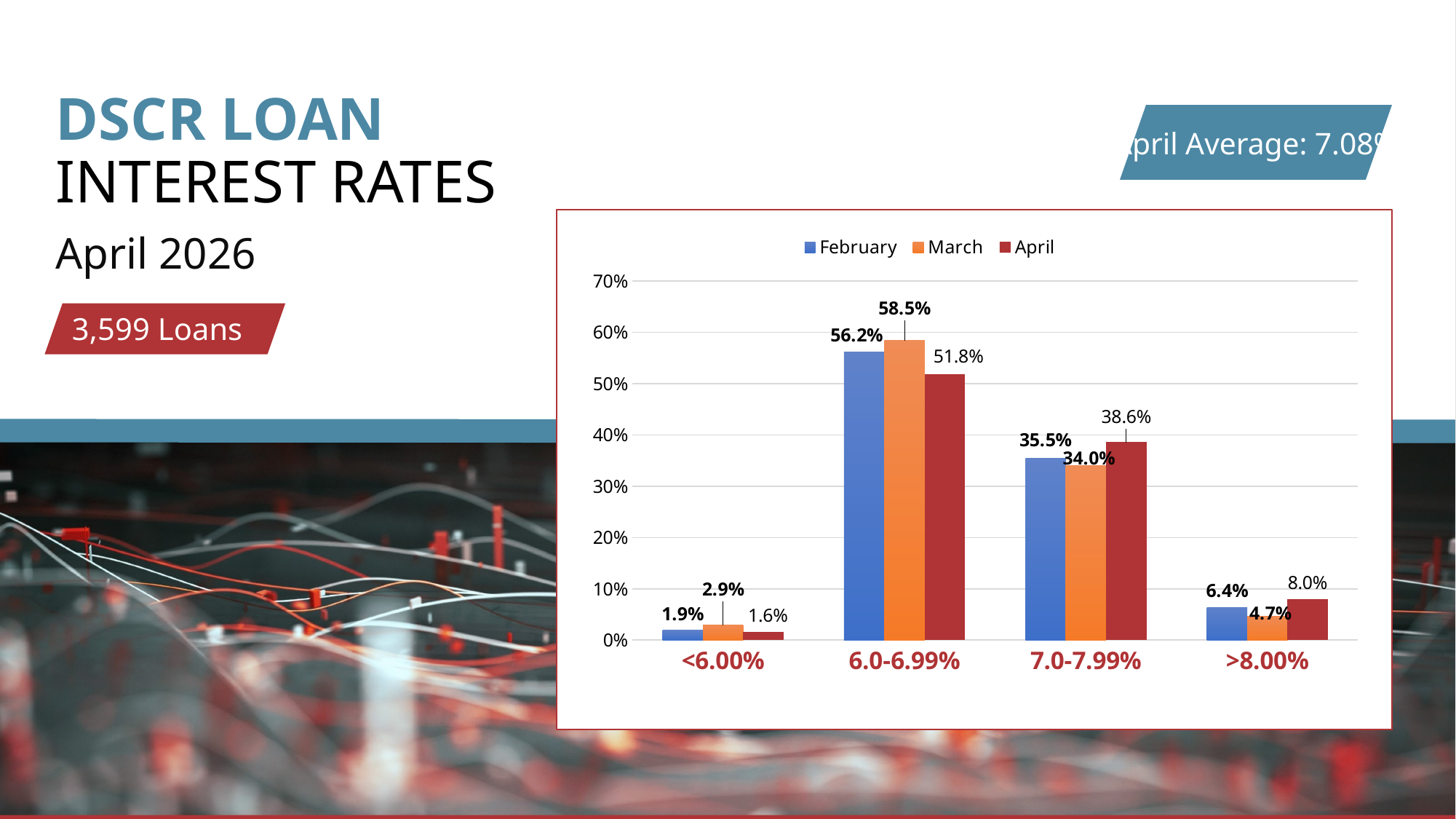
How many categories are shown on the x axis? 4 Which series is shown in dark red in the legend? April What is the difference between the March and February values for the 6.0-6.99% category? 2.3% What kind of chart is shown on the slide? bar chart Is the April value for the 7.0-7.99% category greater or less than 30%? greater How many series does the legend list? 3 What is the April value for the 6.0-6.99% category? 51.8% Which category has the highest March value? 6.0-6.99% Which is larger for the 7.0-7.99% category, the February value or the April value? April Which category has the lowest April value? <6.00% What is the February value for the >8.00% category? 6.4% What is the March value for the 7.0-7.99% category? 34.0%